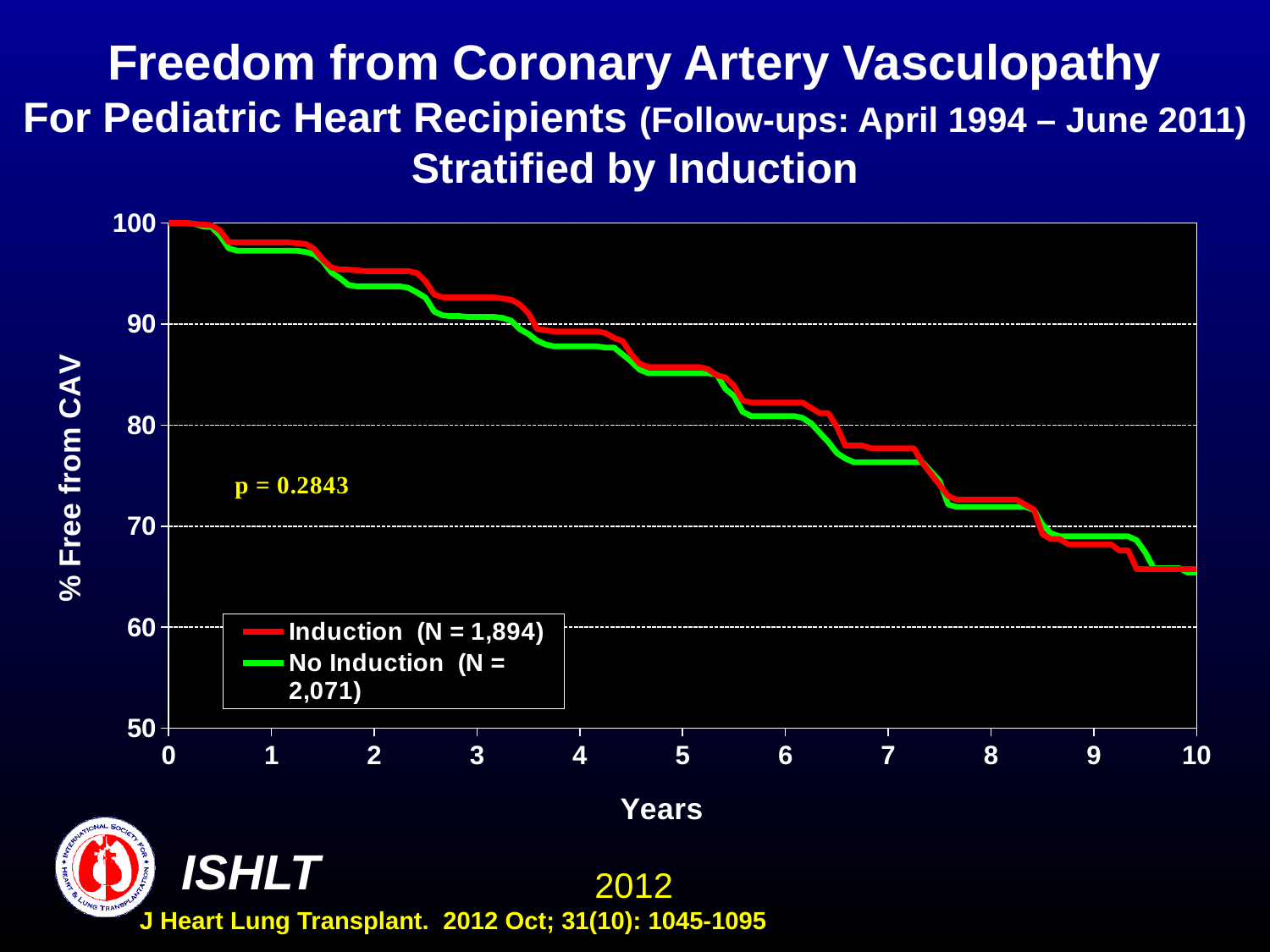
What is the N for the No Induction series according to the legend? 2,071 What kind of chart is shown on the slide? line chart Do the values for the Induction series rise or fall as years increase? fall Is the value for No Induction at year 7 greater or less than 80? less Is the value for No Induction at year 10 greater or less than 70? less How many series does the legend list? 2 Is the value for Induction at year 2 greater or less than 90? greater What is the p-value shown on the chart? p = 0.2843 Do the values for the No Induction series rise or fall along the x axis? fall